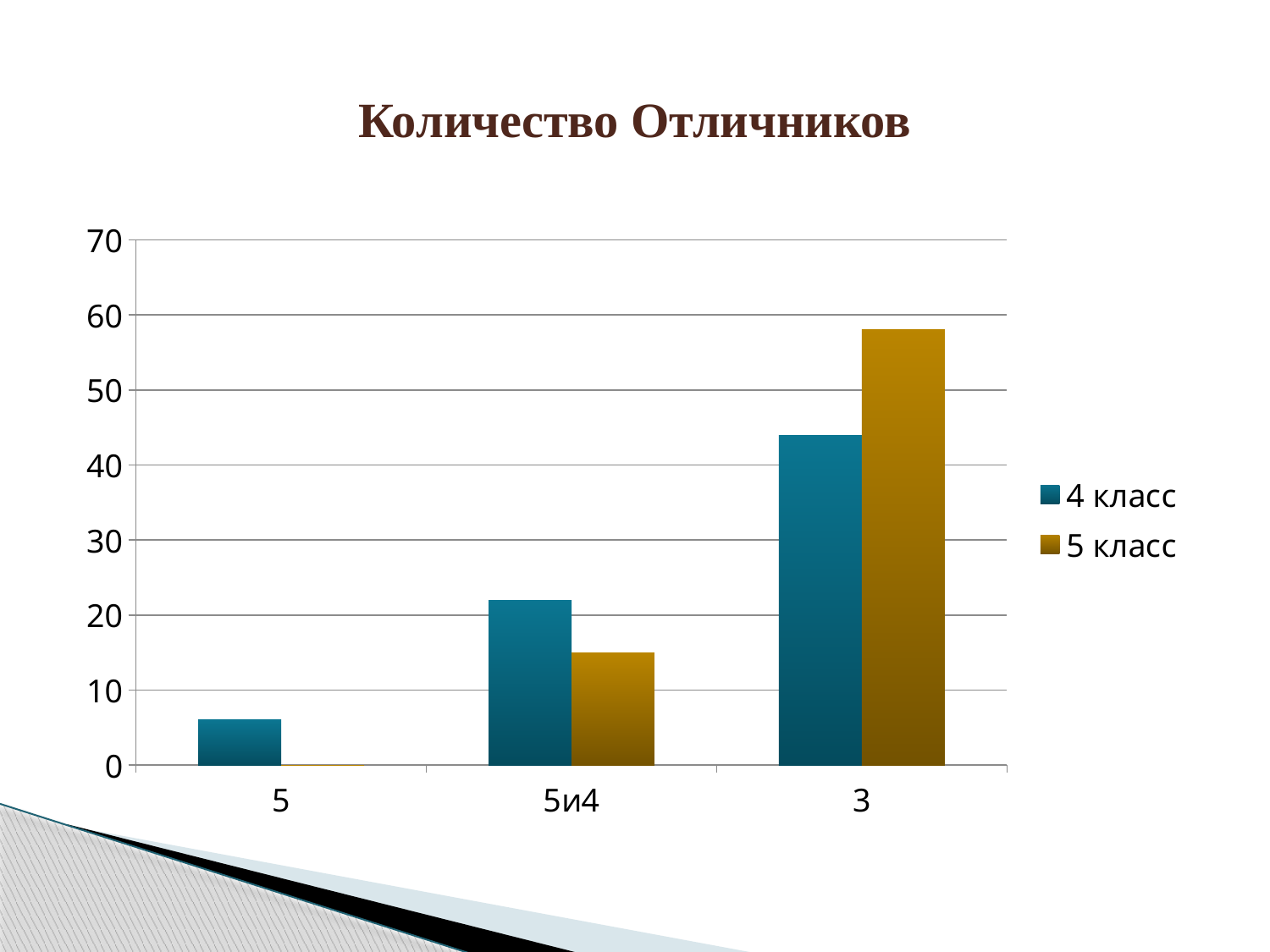
In category 3, which series has the larger value, 4 класс or 5 класс? 5 класс What kind of chart is shown on the slide? bar chart Do the values for the 4 класс series rise or fall from left to right along the x axis? rise What is the title of the chart? Количество Отличников Which category has the highest value for the 5 класс series? 3 How many categories are shown on the x axis? 3 Is the value for 5 класс in category 3 greater or less than 50? greater In category 5и4, which series has the larger value, 4 класс or 5 класс? 4 класс Which category has the lowest value for the 4 класс series? 5 Is the value for 4 класс in category 5и4 greater or less than 30? less How many series does the legend list? 2 Is the value for 4 класс in category 3 greater or less than 40? greater